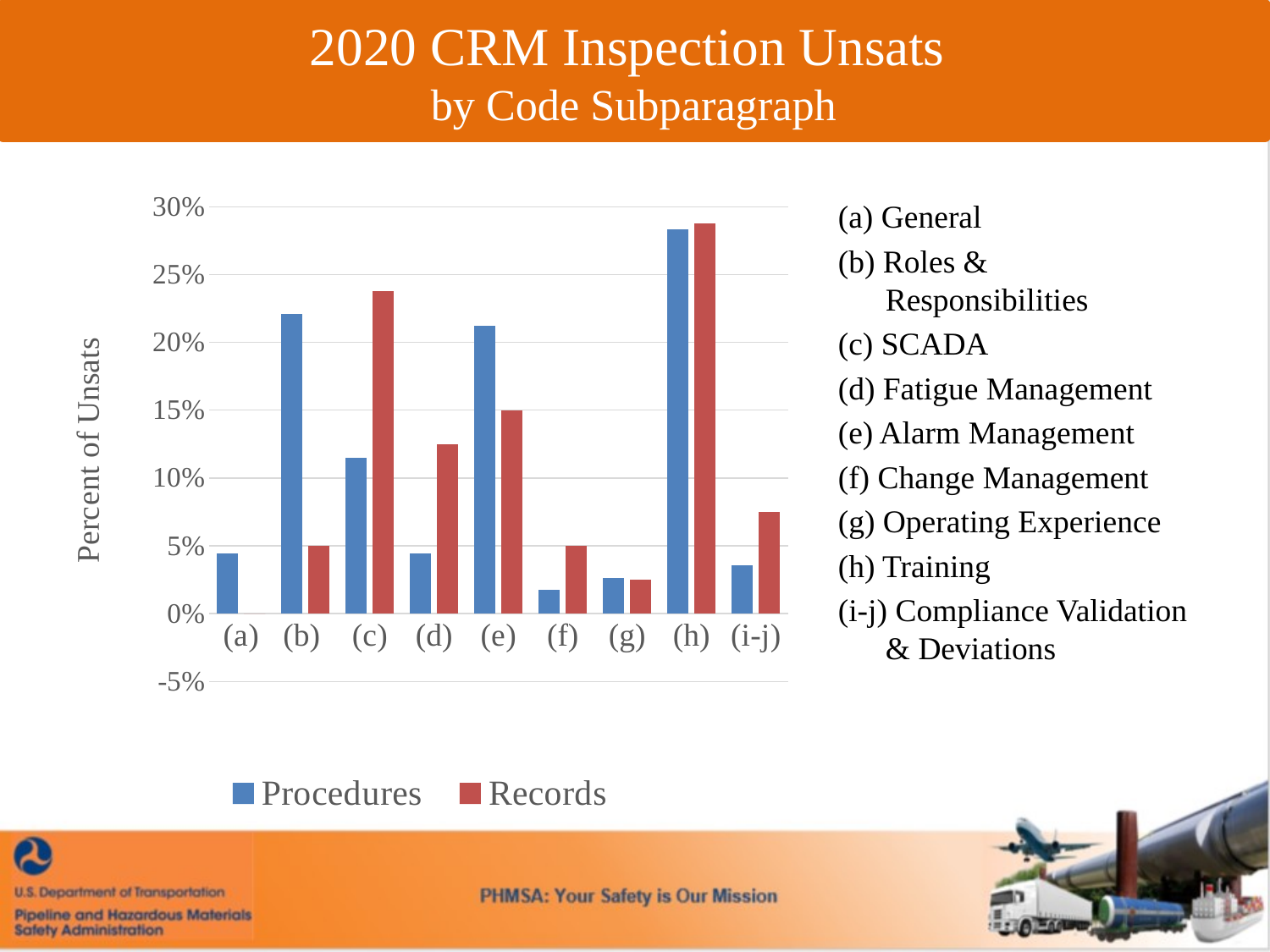
How many code subparagraph categories are shown on the x axis? 9 What kind of chart is shown on the slide? bar chart Is the Procedures value for (h) greater or less than 25%? greater How many series does the legend list? 2 For category (b), which is larger, Procedures or Records? Procedures Which category has the highest Records value? (h) What is the label on the vertical axis of the chart? Percent of Unsats For category (c), which is larger, Procedures or Records? Records Is the Records value for (c) greater or less than 20%? greater Which category has the highest Procedures value? (h) For category (e), which is larger, Procedures or Records? Procedures Is the Procedures value for (f) greater or less than 5%? less